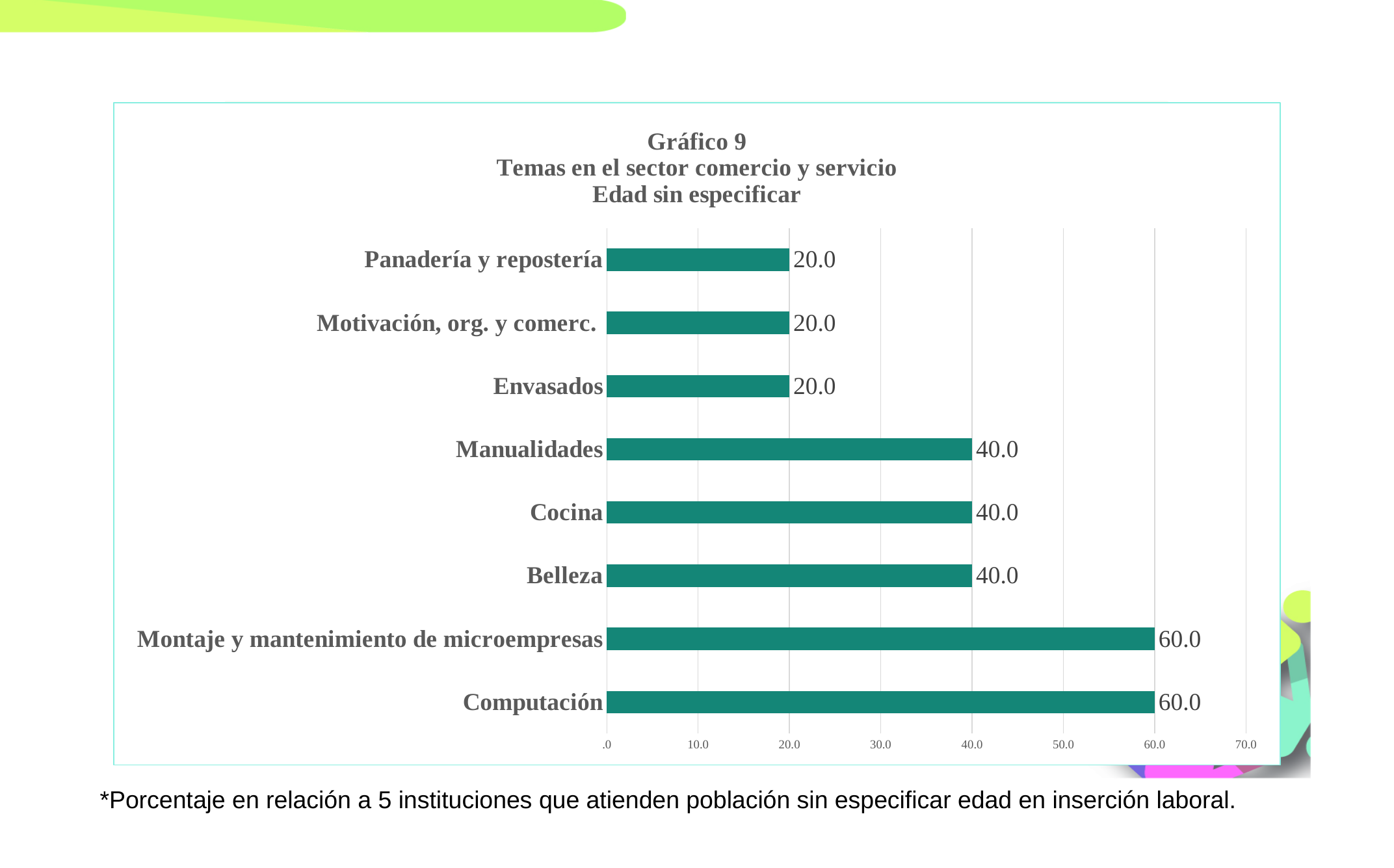
What is the value for Montaje y mantenimiento de microempresas? 60.0 What is the title of the chart? Gráfico 9 Temas en el sector comercio y servicio Edad sin especificar What is the value for Envasados? 20.0 Which is larger, the value for Belleza or the value for Motivación, org. y comerc.? Belleza Is the value for Manualidades greater or less than 30.0? greater How many categories are shown in the chart? 8 What is the value for Computación? 60.0 What kind of chart is shown on the slide? Bar chart Which is larger, the value for Montaje y mantenimiento de microempresas or the value for Cocina? Montaje y mantenimiento de microempresas What is the value for Manualidades? 40.0 What is the difference between the values for Cocina and Panadería y repostería? 20.0 What is the difference between the values for Computación and Belleza? 20.0